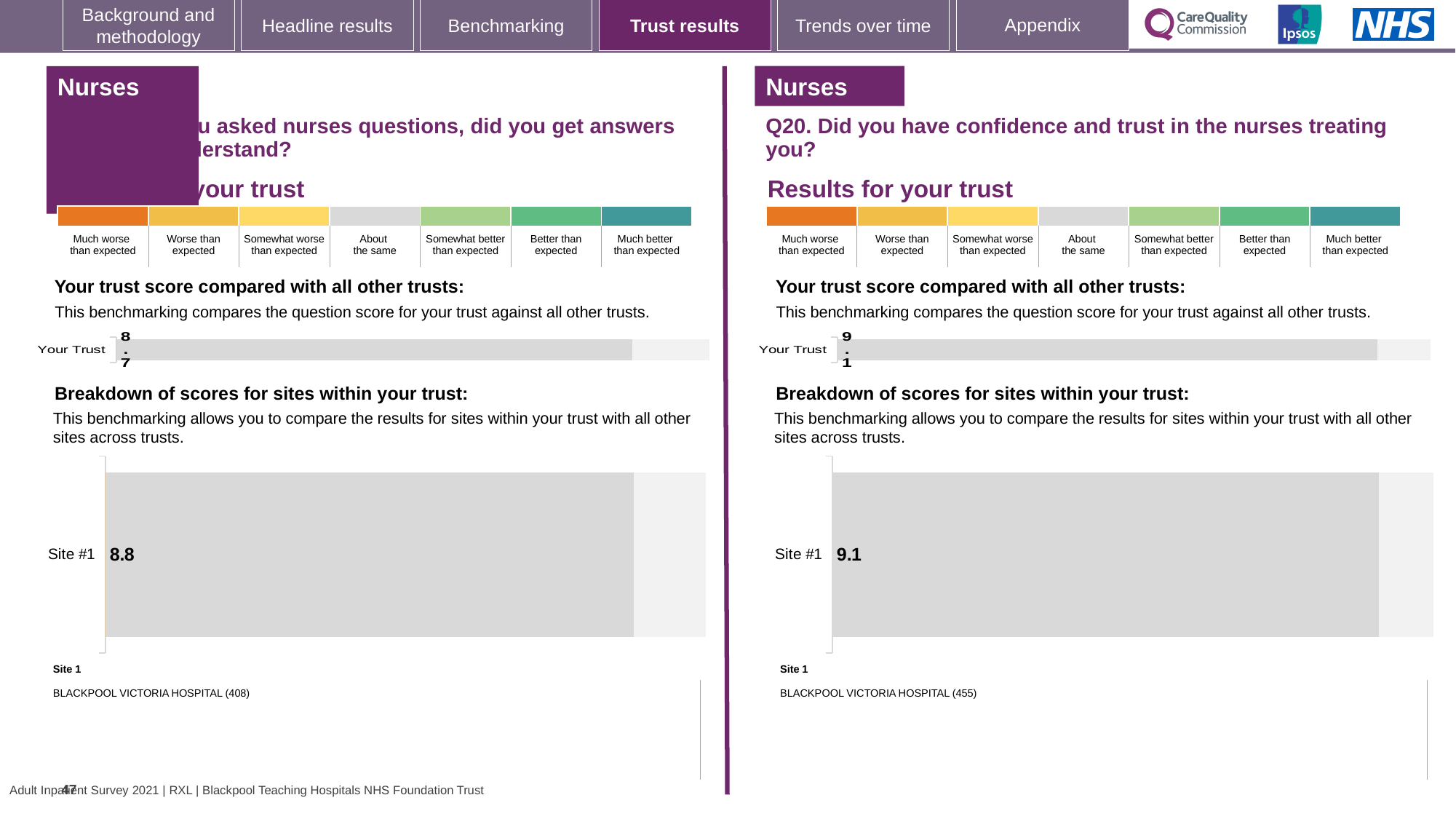
On the right half of the slide, what is the difference between the Site #1 score and the Your Trust score? 0 What kind of chart is used to show the Your Trust score on the right half of the slide? Bar chart What question is the right half of the slide about? Q20. Did you have confidence and trust in the nurses treating you? On the left half of the slide, what is the difference between the Site #1 score (8.8) and the Your Trust score (8.7)? 0.1 On the right half of the slide (Q20), in the 'Breakdown of scores for sites within your trust' chart, what is the value for Site #1? 9.1 How many sites are shown in the 'Breakdown of scores for sites within your trust' chart on the left half of the slide? 1 On the left half of the slide, in the 'Breakdown of scores for sites within your trust' chart, what is the value for Site #1? 8.8 What is the name of the site listed as Site 1 below the charts on the right half of the slide? BLACKPOOL VICTORIA HOSPITAL (455) On the left half of the slide, in the 'Your trust score compared with all other trusts' chart, what is the value for Your Trust? 8.7 Which is larger: the Your Trust score on the left half of the slide or the Your Trust score on the right half (Q20)? Right half (Q20), 9.1 How many sites are shown in the 'Breakdown of scores for sites within your trust' chart on the right half of the slide? 1 On the right half of the slide (Q20), in the 'Your trust score compared with all other trusts' chart, what is the value for Your Trust? 9.1